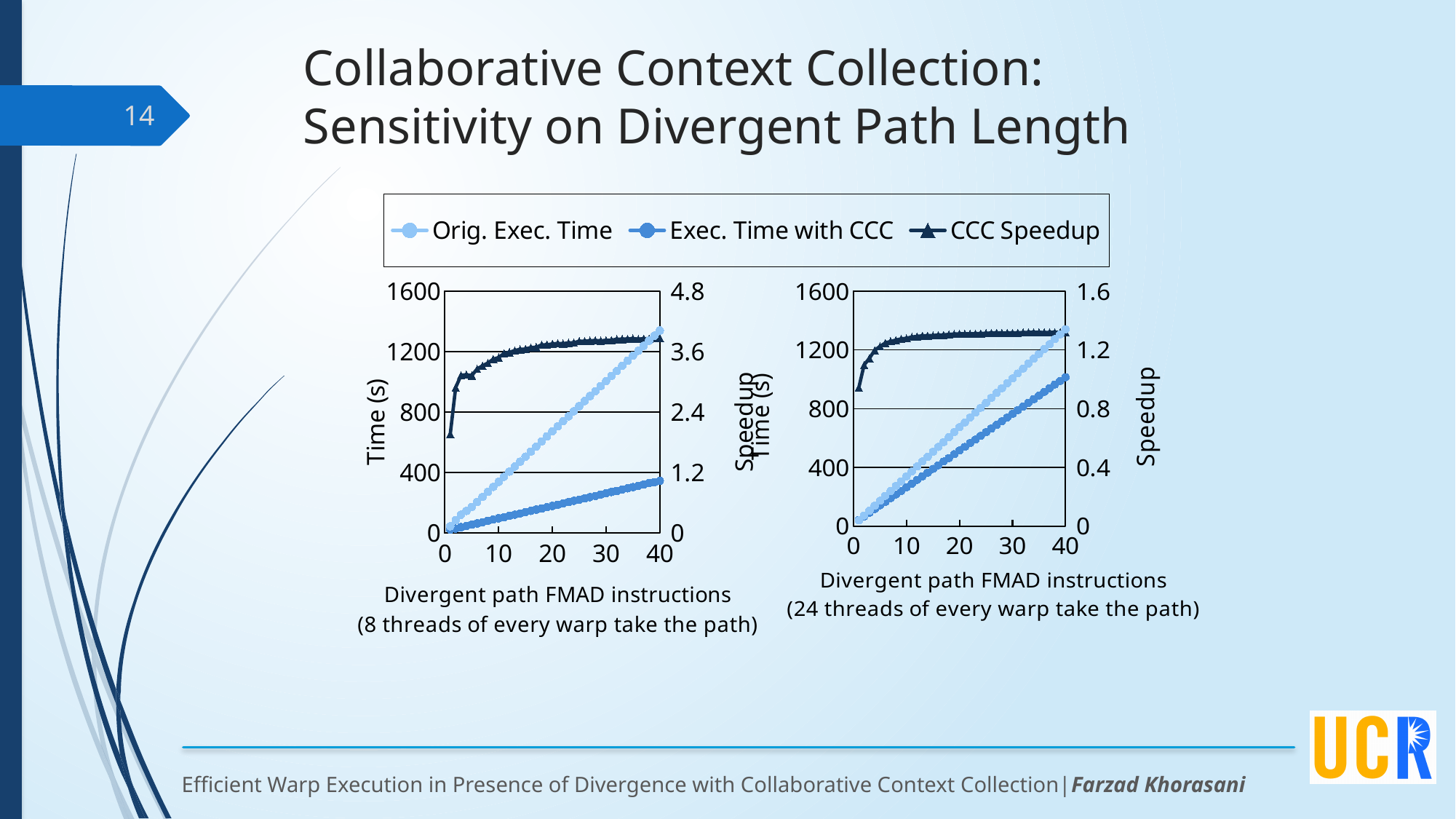
How many series does the legend list? 3 In the right chart (24 threads of every warp take the path), is the Exec. Time with CCC at 40 instructions greater or less than 800? greater In the left chart (8 threads of every warp take the path), is the Orig. Exec. Time at 40 instructions greater or less than 1200? greater What are the three series named in the legend? Orig. Exec. Time, Exec. Time with CCC, CCC Speedup What is the label of the left vertical axis on each chart? Time (s) In the left chart (8 threads of every warp take the path), is the Exec. Time with CCC at 40 instructions greater or less than 400? less What kind of chart is the left chart (8 threads of every warp take the path)? line chart In the left chart (8 threads of every warp take the path), does Orig. Exec. Time rise or fall as the number of divergent path FMAD instructions increases? rise In the right chart (24 threads of every warp take the path), does the Exec. Time with CCC rise or fall along the x axis? rise In the right chart (24 threads of every warp take the path), which is larger at 40 instructions: Orig. Exec. Time or Exec. Time with CCC? Orig. Exec. Time